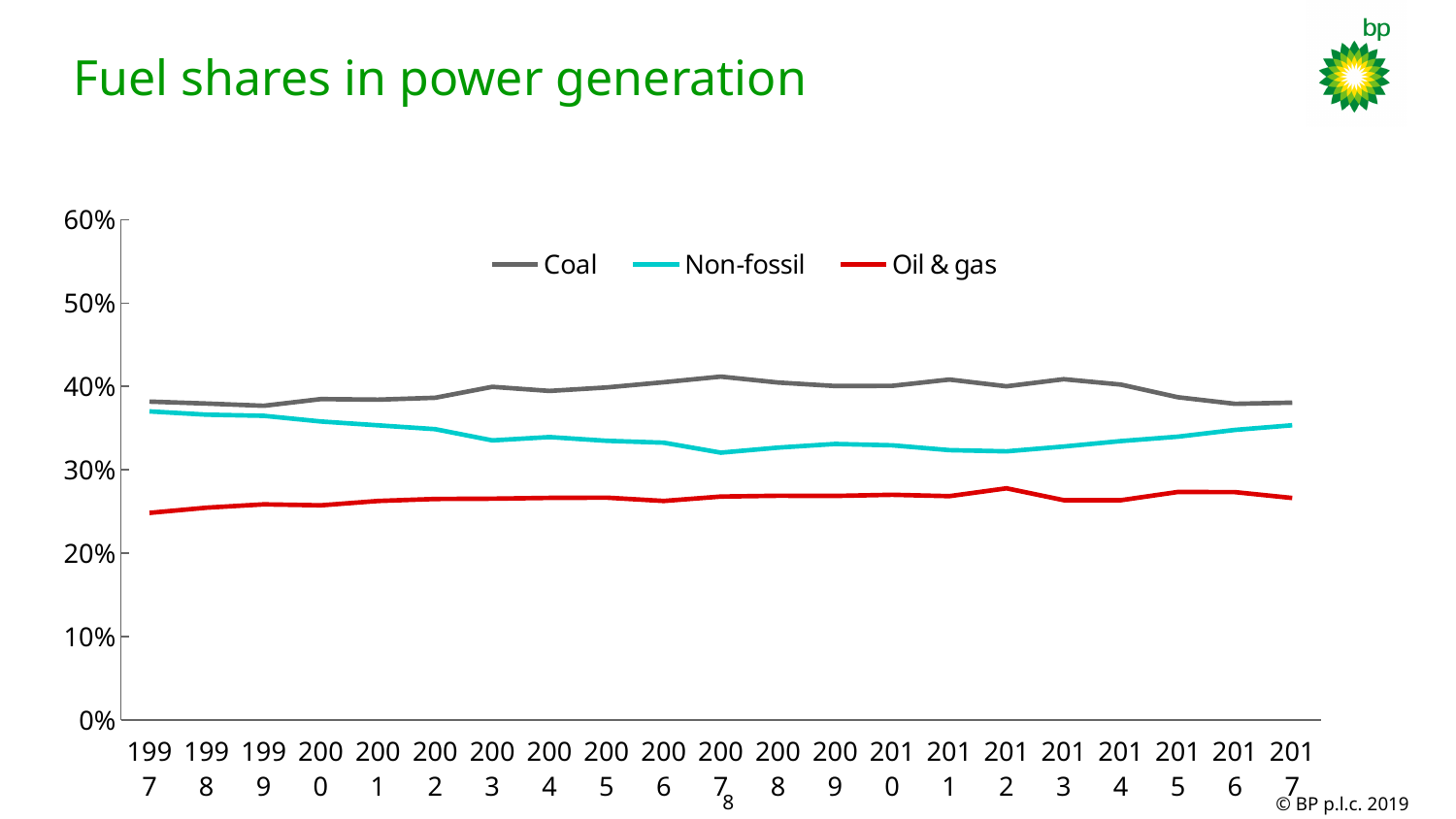
What is the title of the chart? Fuel shares in power generation Is the value for Non-fossil in 2007 greater or less than 30%? greater Which series are listed in the legend? Coal, Non-fossil, Oil & gas Which series has the lowest share across all years shown? Oil & gas Which series has the highest share across all years shown? Coal What kind of chart is shown on the slide? Line chart How many years are plotted along the x axis? 21 Is the value for Coal in 1997 greater or less than 40%? less Does the Non-fossil share rise or fall between 1997 and 2007? Fall How many series does the legend list? 3 In 2017, which is larger: the share for Non-fossil or the share for Oil & gas? Non-fossil Is the value for Oil & gas in 1997 greater or less than 30%? less